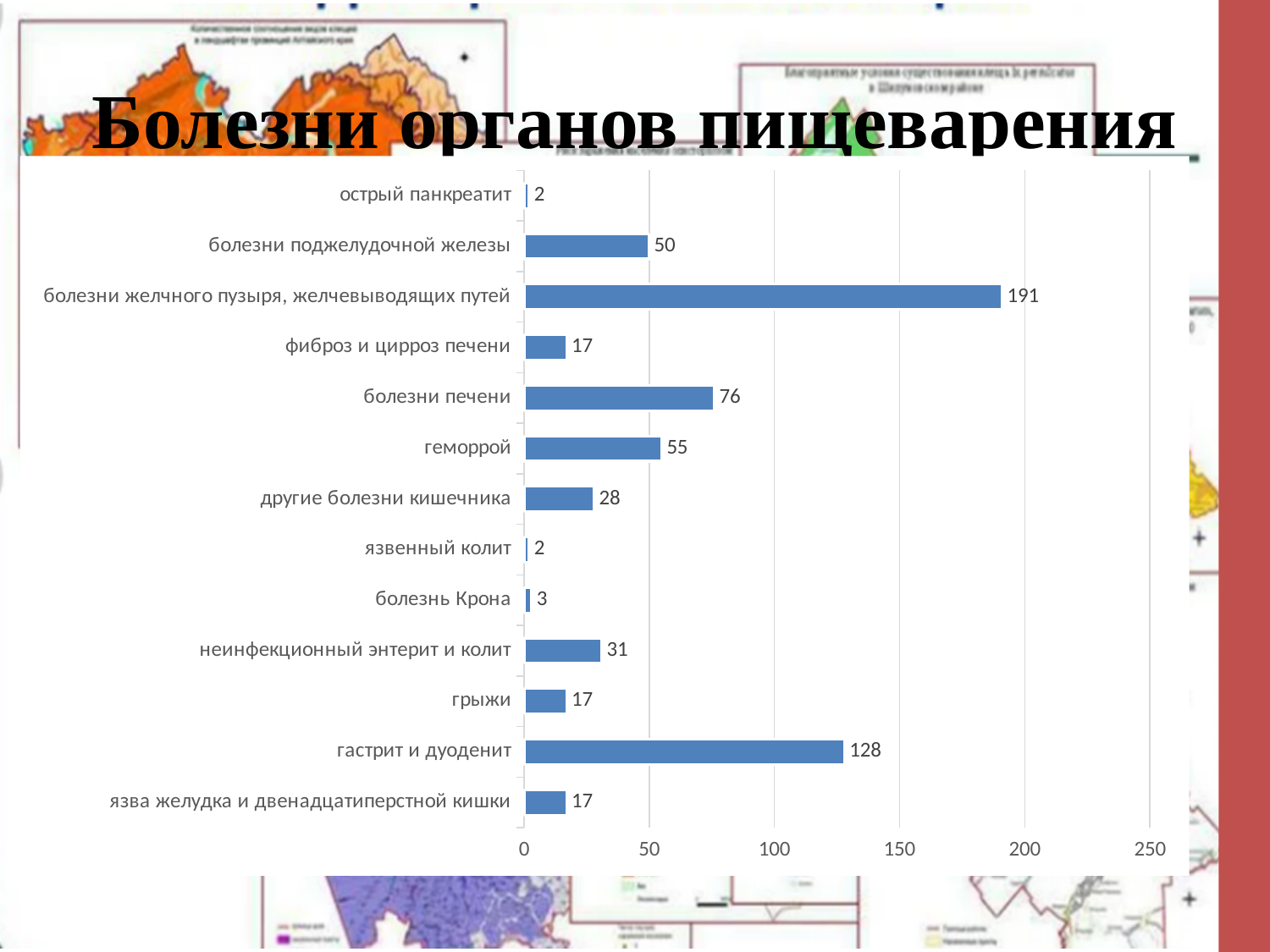
Is the value for гастрит и дуоденит greater or less than 100? greater What is the title of the slide? Болезни органов пищеварения What is the difference between the values for болезни желчного пузыря, желчевыводящих путей and гастрит и дуоденит? 63 Which is larger, the value for другие болезни кишечника or the value for неинфекционный энтерит и колит? неинфекционный энтерит и колит What is the value for болезни печени? 76 How many categories are shown in the chart? 13 Which is larger, the value for болезни печени or the value for геморрой? болезни печени What is the value for неинфекционный энтерит и колит? 31 Which category has the highest value? болезни желчного пузыря, желчевыводящих путей What is the value for гастрит и дуоденит? 128 What kind of chart is shown on the slide? bar chart What is the difference between the values for геморрой and болезни поджелудочной железы? 5